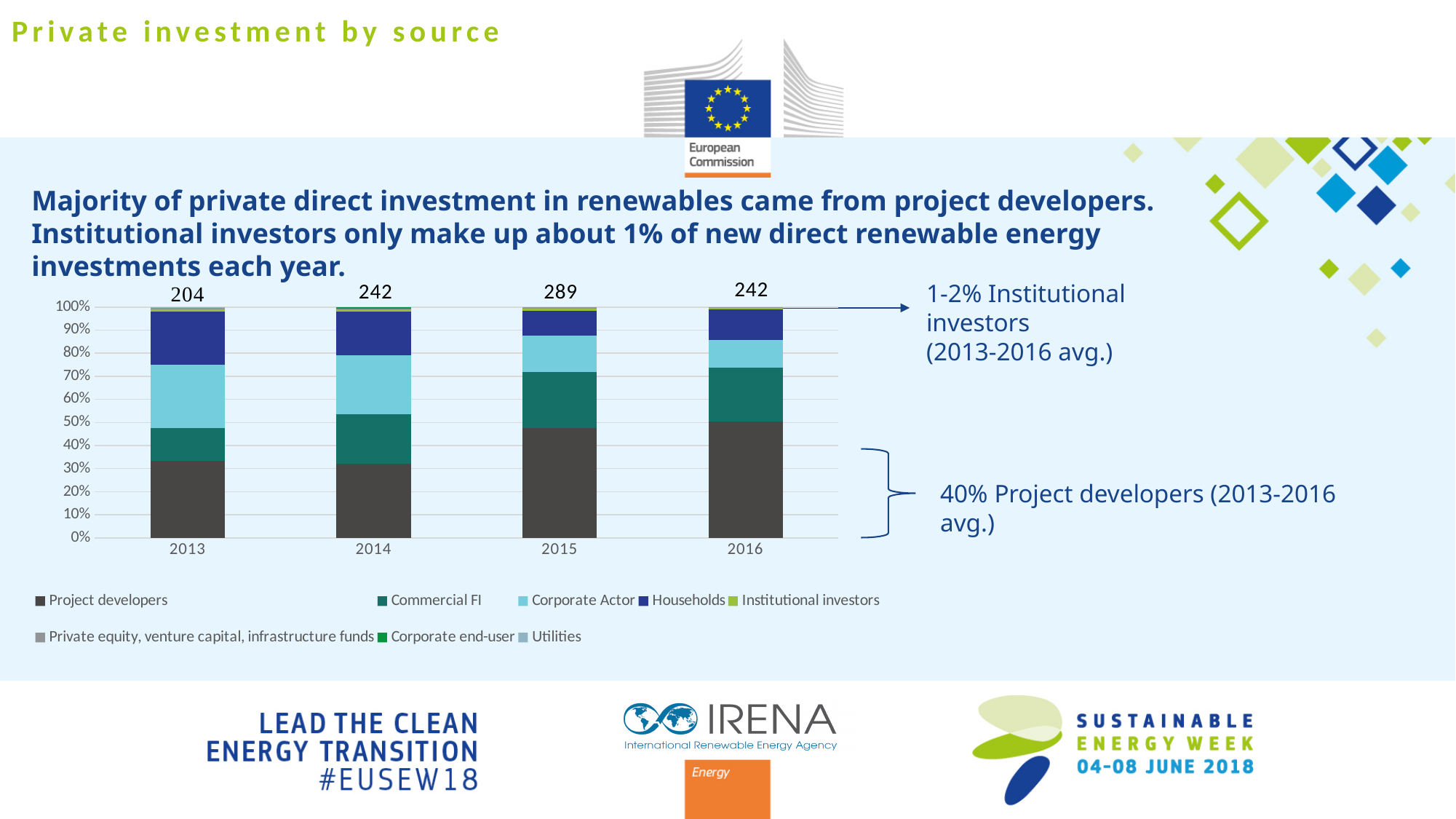
Is the Project developers share of the 2013 bar greater or less than 40%? less What kind of chart is shown on the slide? Stacked bar chart What is the difference between the total labelled for 2015 and the total labelled for 2013? 85 Which year has the highest total value labelled above its bar? 2015 Which year has the larger labelled total, 2013 or 2014? 2014 How many years are shown on the x axis of the chart? 4 How many series does the chart legend list? 8 Which year has the lowest total value labelled above its bar? 2013 What is the total value labelled above the 2015 bar? 289 What is the total value labelled above the 2013 bar? 204 Is the Project developers share of the 2016 bar greater or less than 40%? greater Which series is shown in dark grey at the bottom of each bar? Project developers